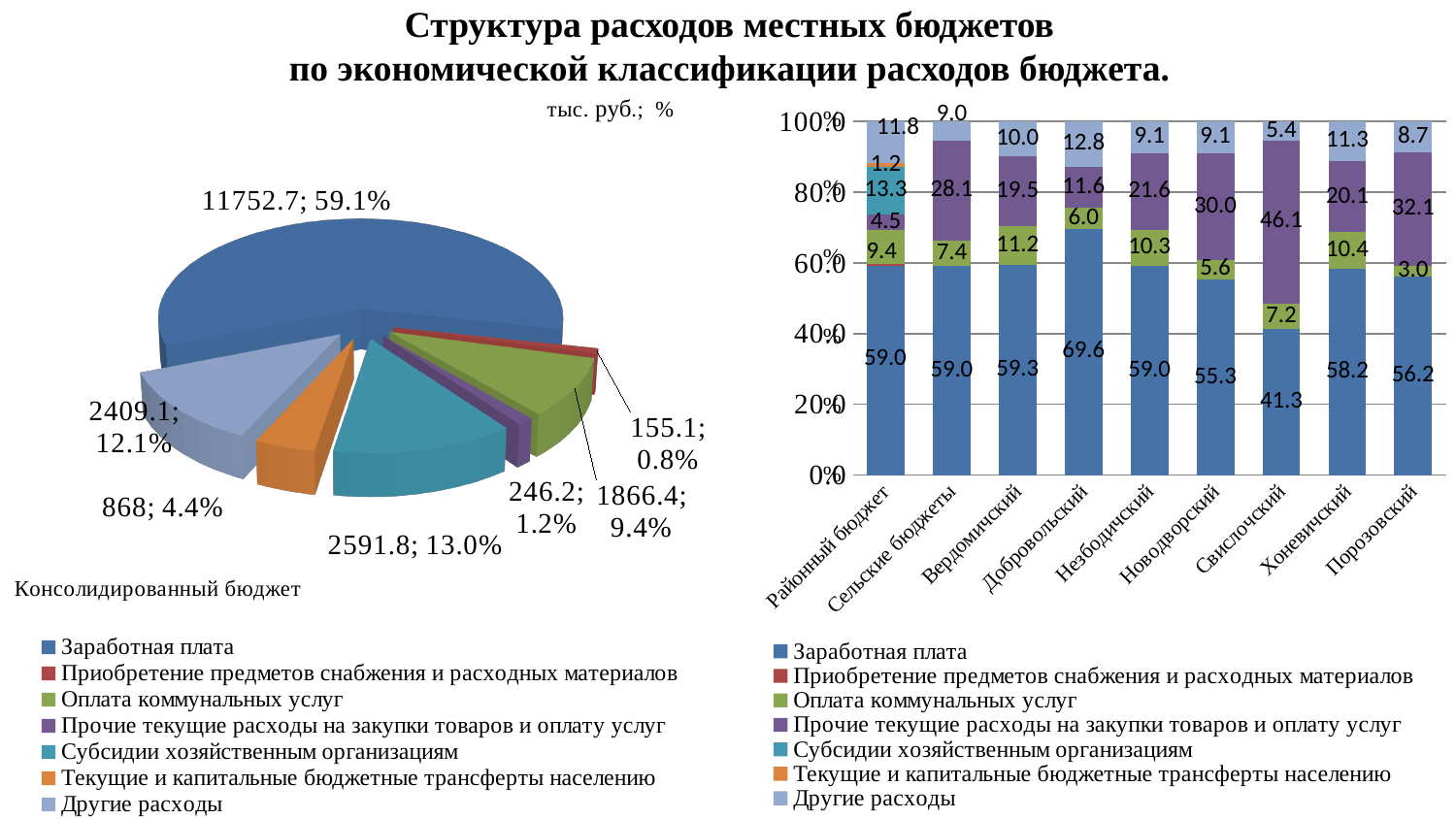
On the pie chart, how many slices are there? 7 What type of chart is on the right side of the slide? Stacked bar chart On the stacked bar chart, which category has the highest Заработная плата value? Добровольский On the stacked bar chart, what is the Прочие текущие расходы value for Порозовский? 32.1 On the pie chart, what is the difference between the values 2591.8 and 2409.1? 182.7 On the pie chart, which slice is the smallest? Приобретение предметов снабжения и расходных материалов (155.1; 0.8%) On the stacked bar chart, how many series does the legend list? 7 On the stacked bar chart, which is larger: the Другие расходы value for Добровольский or for Свислочский? Добровольский On the pie chart (Консолидированный бюджет), what value and share are shown for the largest slice, Заработная плата? 11752.7; 59.1% On the stacked bar chart, what is the Заработная плата value for Свислочский? 41.3 On the pie chart, what share does the slice labelled 2591.8 represent? 13.0% On the stacked bar chart, how many categories are shown on the x axis? 9